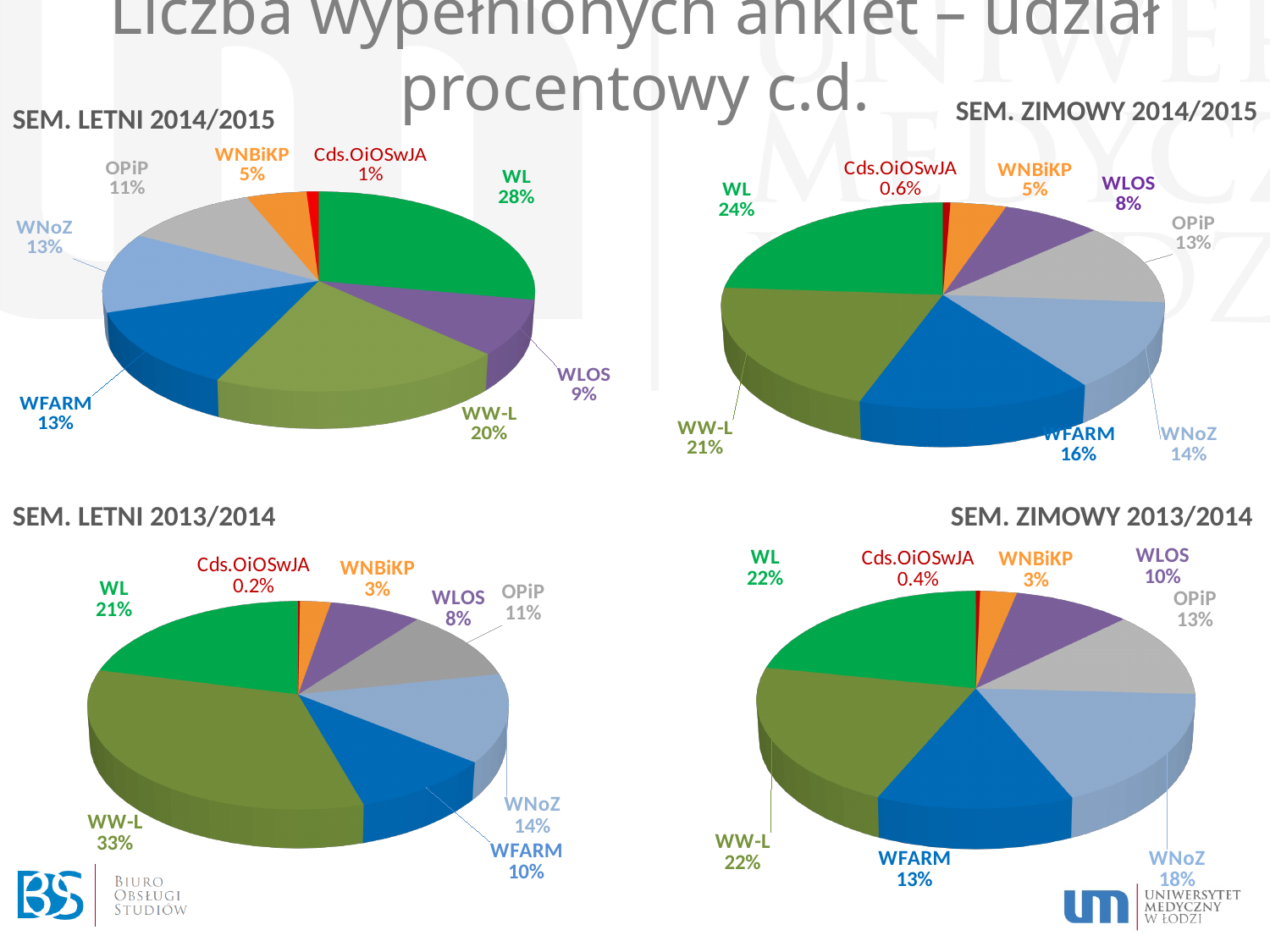
In the SEM. ZIMOWY 2014/2015 pie chart, what share does WFARM have? 16% How many slices does the SEM. LETNI 2014/2015 pie chart have? 8 In the SEM. LETNI 2013/2014 pie chart, what share does Cds.OiOSwJA have? 0.2% In the SEM. LETNI 2014/2015 pie chart, what share does WL have? 28% What type of chart is used for SEM. ZIMOWY 2013/2014? Pie chart In the SEM. ZIMOWY 2014/2015 pie chart, what share does WNBiKP have? 5% How many pie charts are shown on the slide? 4 In the SEM. ZIMOWY 2013/2014 pie chart, what share does WNoZ have? 18% In the SEM. LETNI 2013/2014 pie chart, which category has the largest share? WW-L In the SEM. ZIMOWY 2013/2014 pie chart, which is larger, the share of WLOS or the share of OPiP? OPiP In the SEM. LETNI 2014/2015 pie chart, what is the difference between the shares of WL and WW-L? 8% In the SEM. ZIMOWY 2014/2015 pie chart, which category has the smallest share? Cds.OiOSwJA